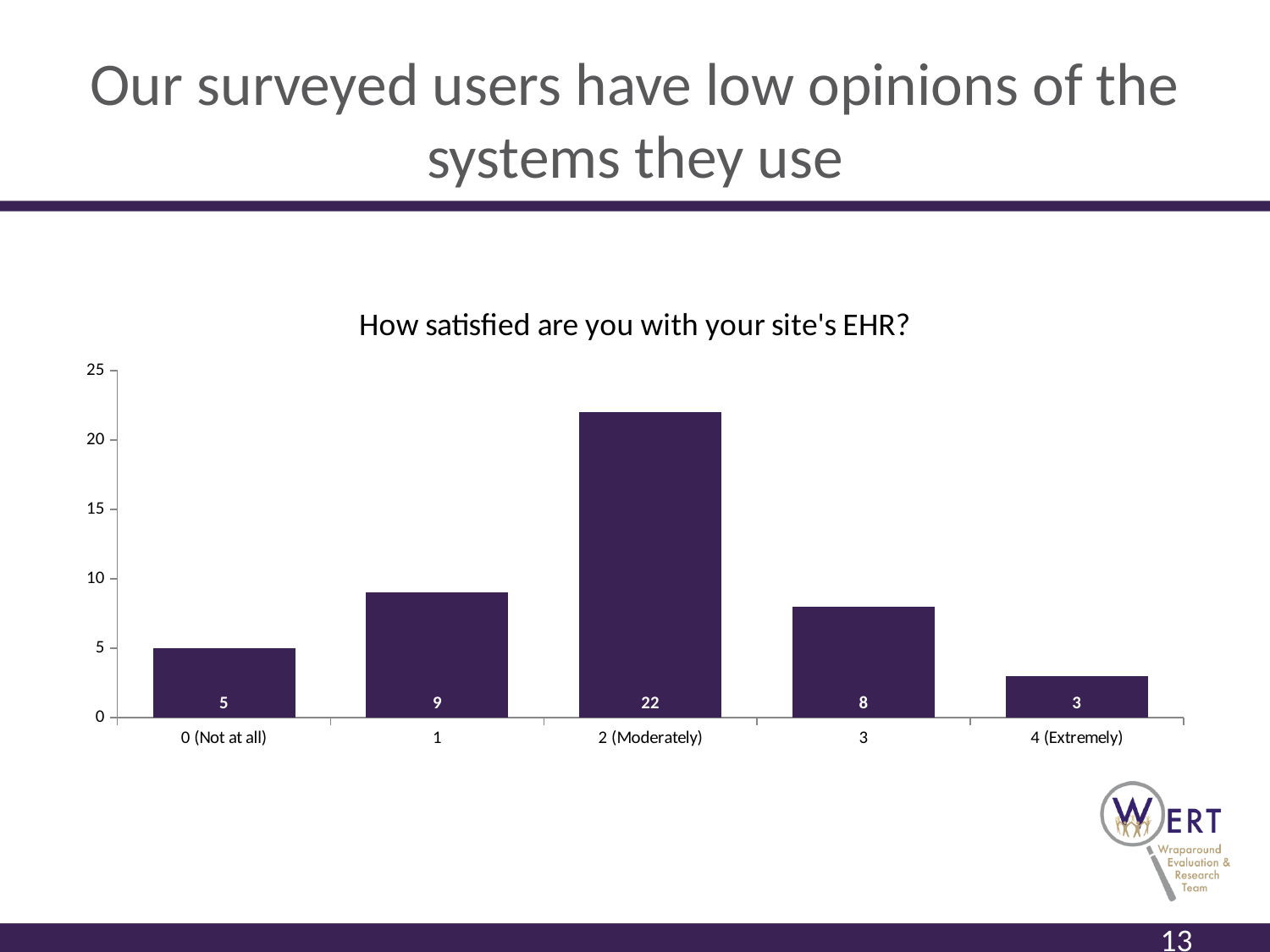
Is the value for "2 (Moderately)" greater or less than 20? greater What is the value for the "0 (Not at all)" category? 5 What is the difference between the values for "1" and "3"? 1 Which category has the highest value? 2 (Moderately) Which category has the lowest value? 4 (Extremely) How many categories are shown on the x axis? 5 What is the value for the "2 (Moderately)" category? 22 Which is larger, the value for "1" or the value for "4 (Extremely)"? 1 What kind of chart is shown on the slide? bar chart What is the title of the chart? How satisfied are you with your site's EHR? What is the value for the "4 (Extremely)" category? 3 What is the difference between the values for "2 (Moderately)" and "1"? 13